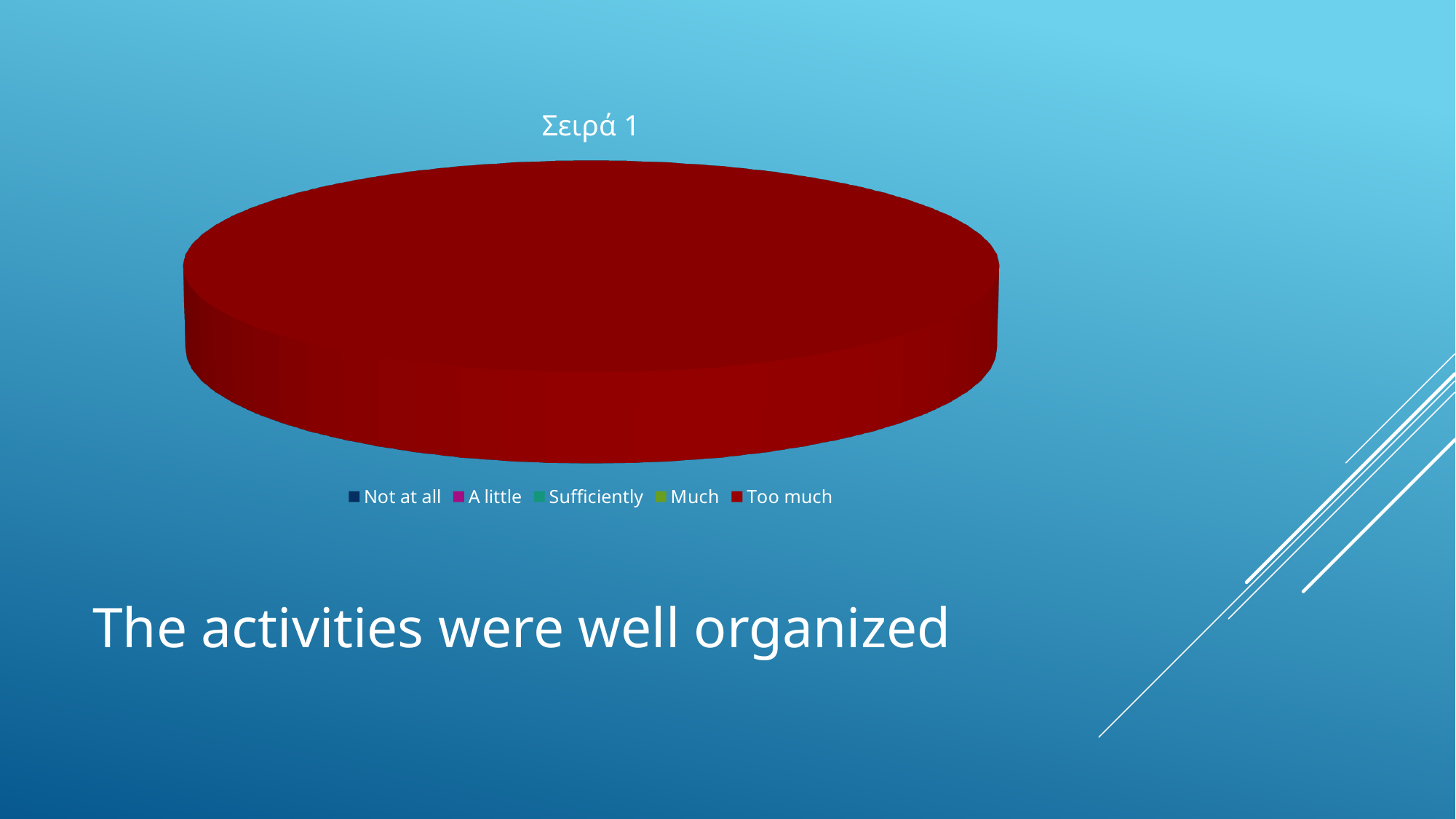
Which category accounts for the largest share of the pie? Too much Which category is shown in dark red in the legend? Too much What kind of chart is shown on the slide? Pie chart Which category is larger in the pie, 'Too much' or 'Much'? Too much Which category is larger in the pie, 'Not at all' or 'Too much'? Too much What is the title of the chart? Σειρά 1 How many categories does the chart's legend list? 5